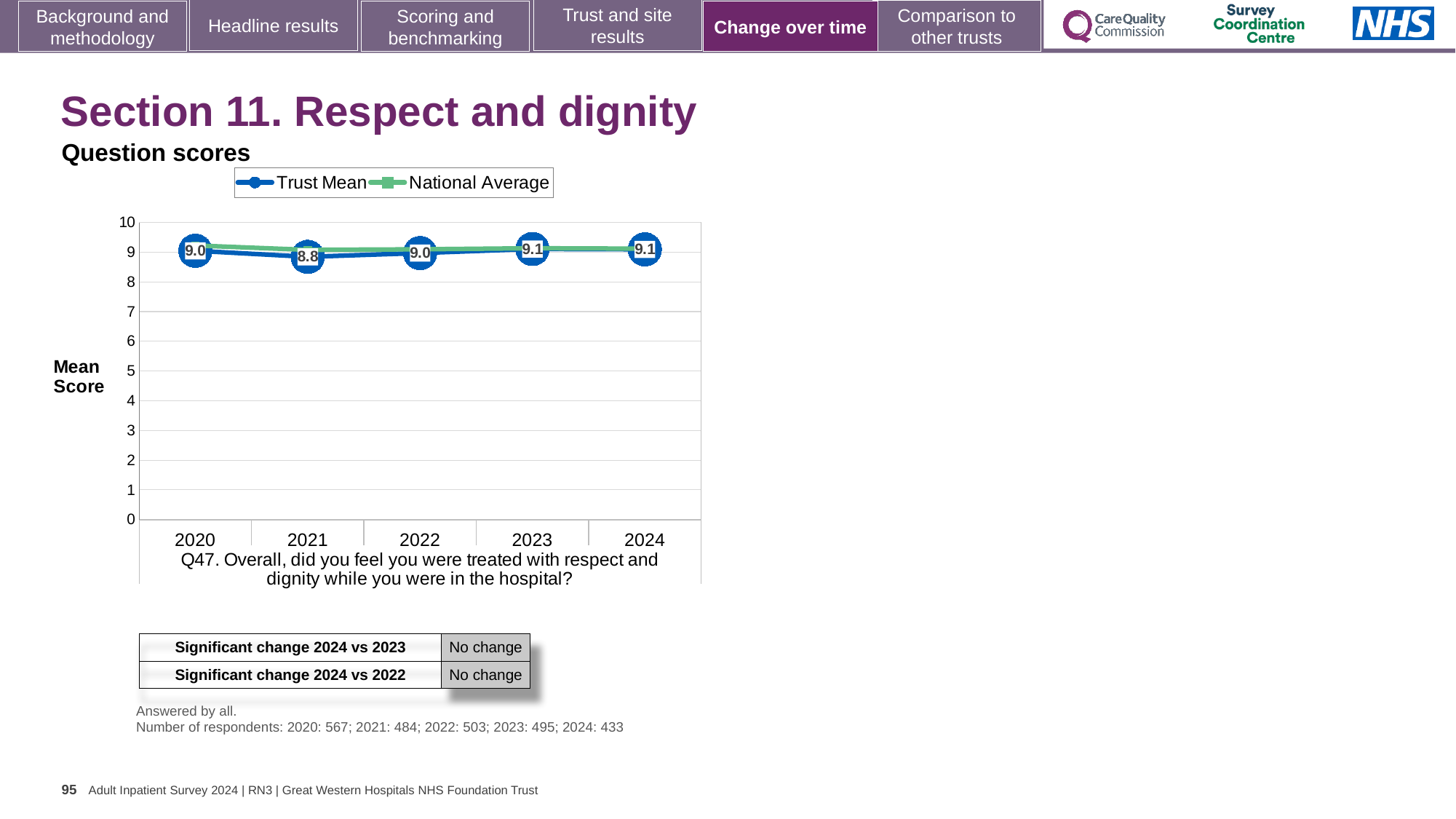
What is the Trust Mean score for 2020? 9.0 Does the Trust Mean score rise or fall from 2021 to 2024? Rise How many years are plotted on the x axis? 5 What is the Trust Mean score for 2024? 9.1 How many series does the legend list? 2 Is the National Average value for 2020 greater or less than 8? greater What is the Trust Mean score for 2021? 8.8 What kind of chart is shown on the slide? Line chart What is the label on the y axis of the chart? Mean Score What is the difference between the Trust Mean score in 2024 and in 2021? 0.3 In which year is the Trust Mean score lowest? 2021 Which is larger, the Trust Mean score for 2021 or for 2023? 2023